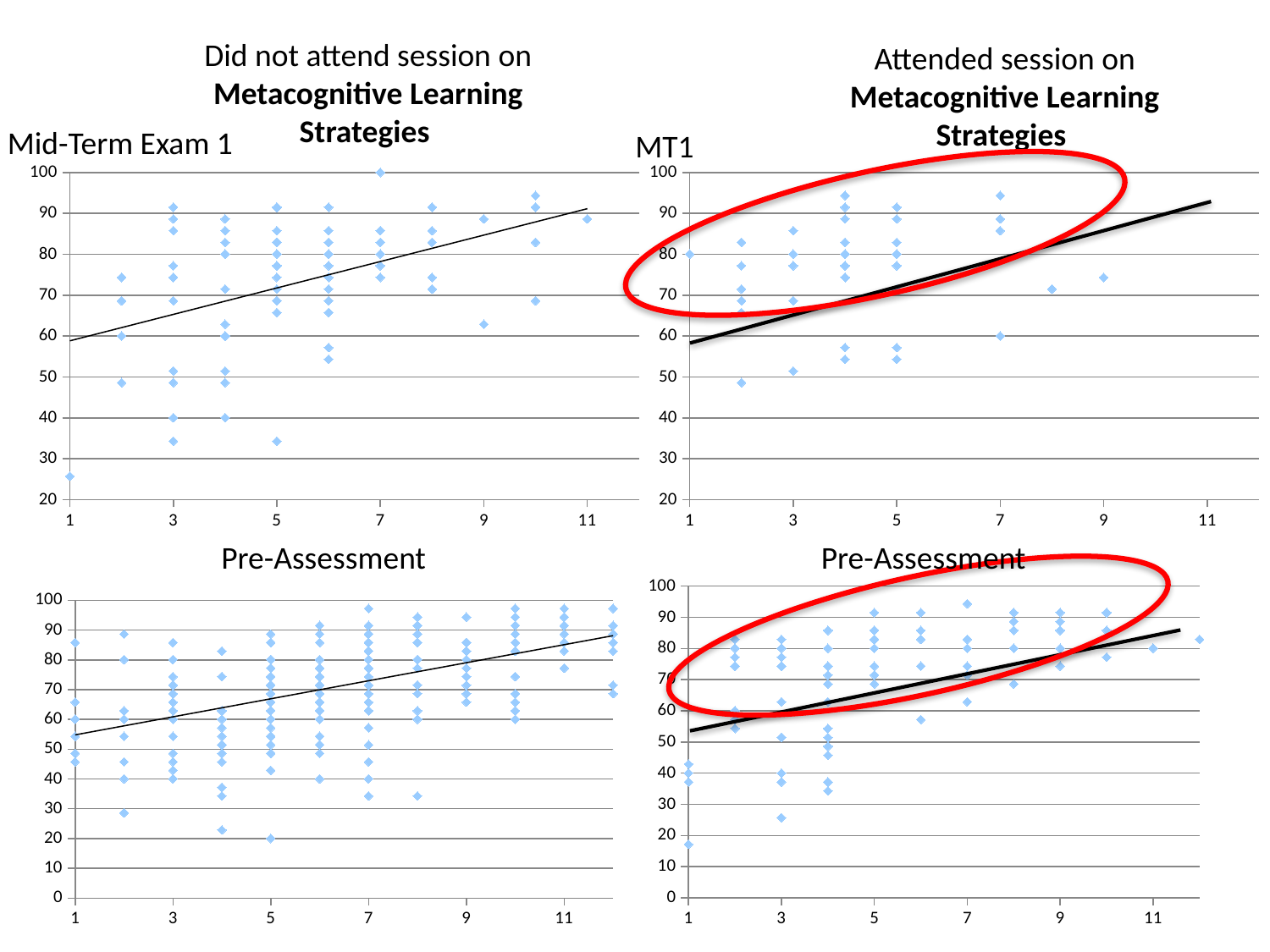
In the bottom-left Pre-Assessment chart, do the values generally rise or fall along the x axis? rise What is the title of the bottom-left chart? Pre-Assessment In the bottom-left Pre-Assessment chart, is the lowest point at x=5 greater or less than 30? less In the bottom-right Pre-Assessment chart, is the lowest point at x=1 greater or less than 20? less What is the lowest value shown on the y axis of the top-left Mid-Term Exam 1 chart? 20 In the top-left Mid-Term Exam 1 chart, is the value of the point at x=1 greater or less than 30? less How many charts are shown on the slide? 4 In the top-left Mid-Term Exam 1 chart, does the trend line rise or fall as the x axis increases? rise What kind of chart is the top-left chart titled Mid-Term Exam 1? scatter chart In the top-right MT1 chart, does the trend line rise or fall from left to right? rise